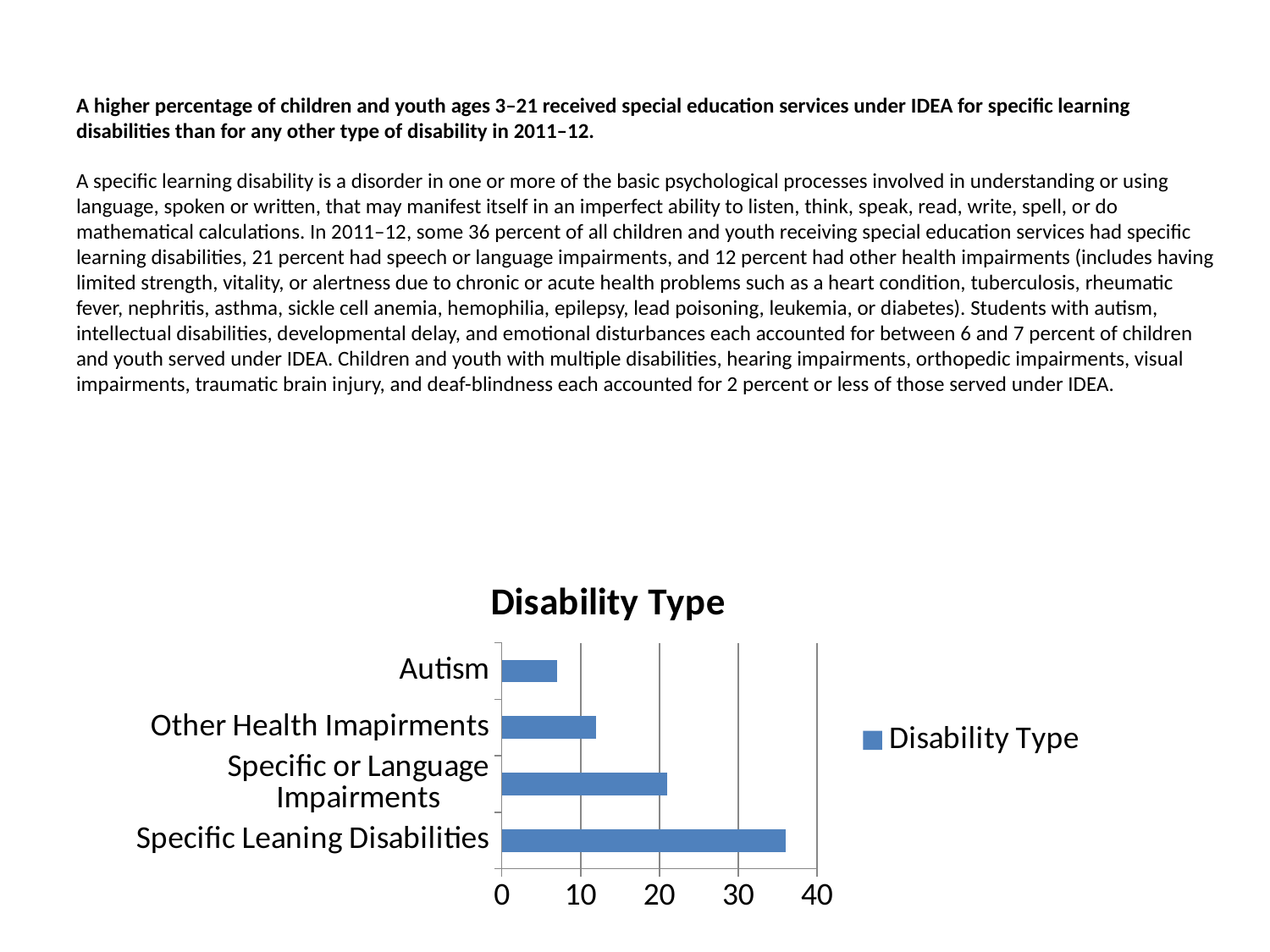
Which category has the highest value in the chart? Specific Leaning Disabilities How many series does the legend list? 1 How many categories are plotted in the chart? 4 What is the title of the chart? Disability Type What kind of chart is shown on the slide? bar chart Is the value for Specific Leaning Disabilities greater or less than 30? greater Is the value for Autism greater or less than 10? less Is the value for Other Health Imapirments greater or less than 20? less Which is larger, the value for Other Health Imapirments or the value for Autism? Other Health Imapirments Which category has the lowest value in the chart? Autism What is the name of the series shown in the legend? Disability Type